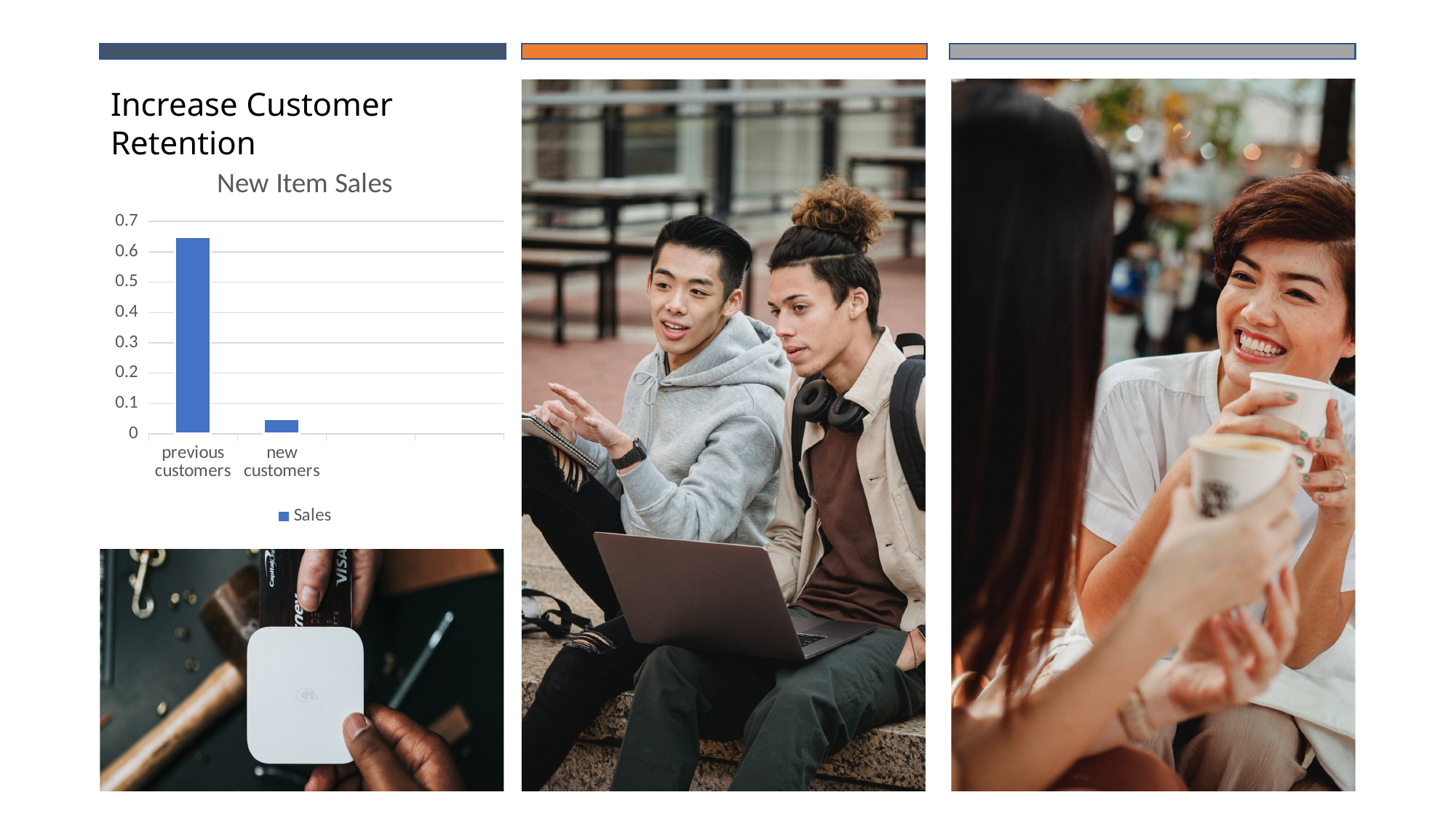
Do the values rise or fall from previous customers to new customers? fall Which category has the lowest value in the chart? new customers Is the value for previous customers greater or less than 0.7? less Which category has the highest value in the chart? previous customers Is the value for previous customers greater or less than 0.6? greater What is the title of the chart? New Item Sales What kind of chart is shown on the slide? bar chart How many categories are shown on the x axis of the chart? 2 Which is larger, the value for previous customers or the value for new customers? previous customers What series name appears in the chart legend? Sales How many series does the chart legend list? 1 Is the value for new customers greater or less than 0.1? less